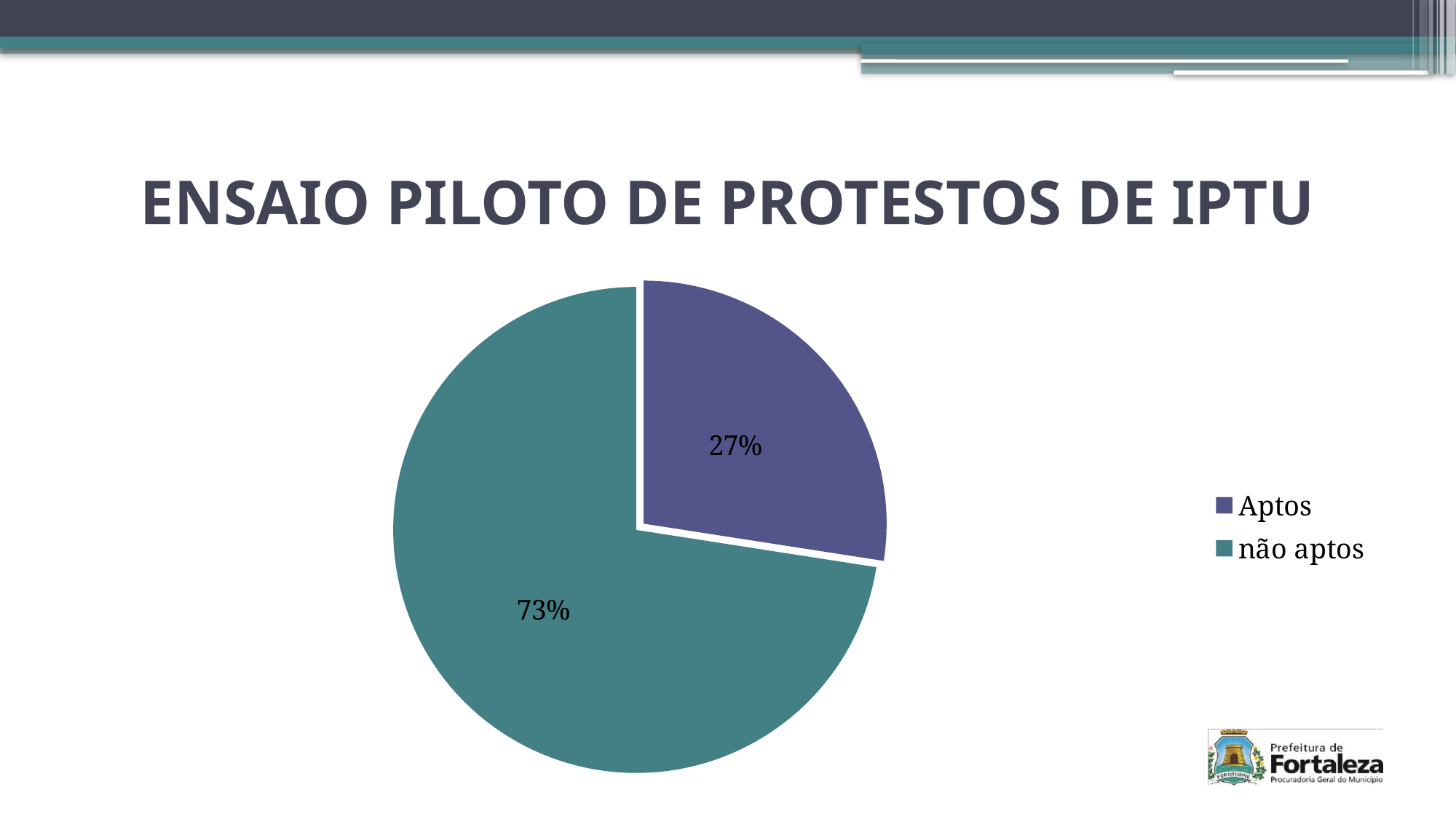
What is the title of the slide containing the chart? ENSAIO PILOTO DE PROTESTOS DE IPTU Which category has the smallest slice of the pie? Aptos Which legend entry is shown in purple? Aptos How many slices does the pie chart have? 2 What is the difference in percentage points between the "não aptos" and "Aptos" slices? 46 Which category has the largest slice of the pie? não aptos Which slice is larger, "Aptos" or "não aptos"? não aptos What share of the pie does the "Aptos" slice represent? 27% What share of the pie does the "não aptos" slice represent? 73% How many entries does the legend list? 2 Is the share for "Aptos" greater or less than 50%? less What kind of chart is shown on the slide? pie chart